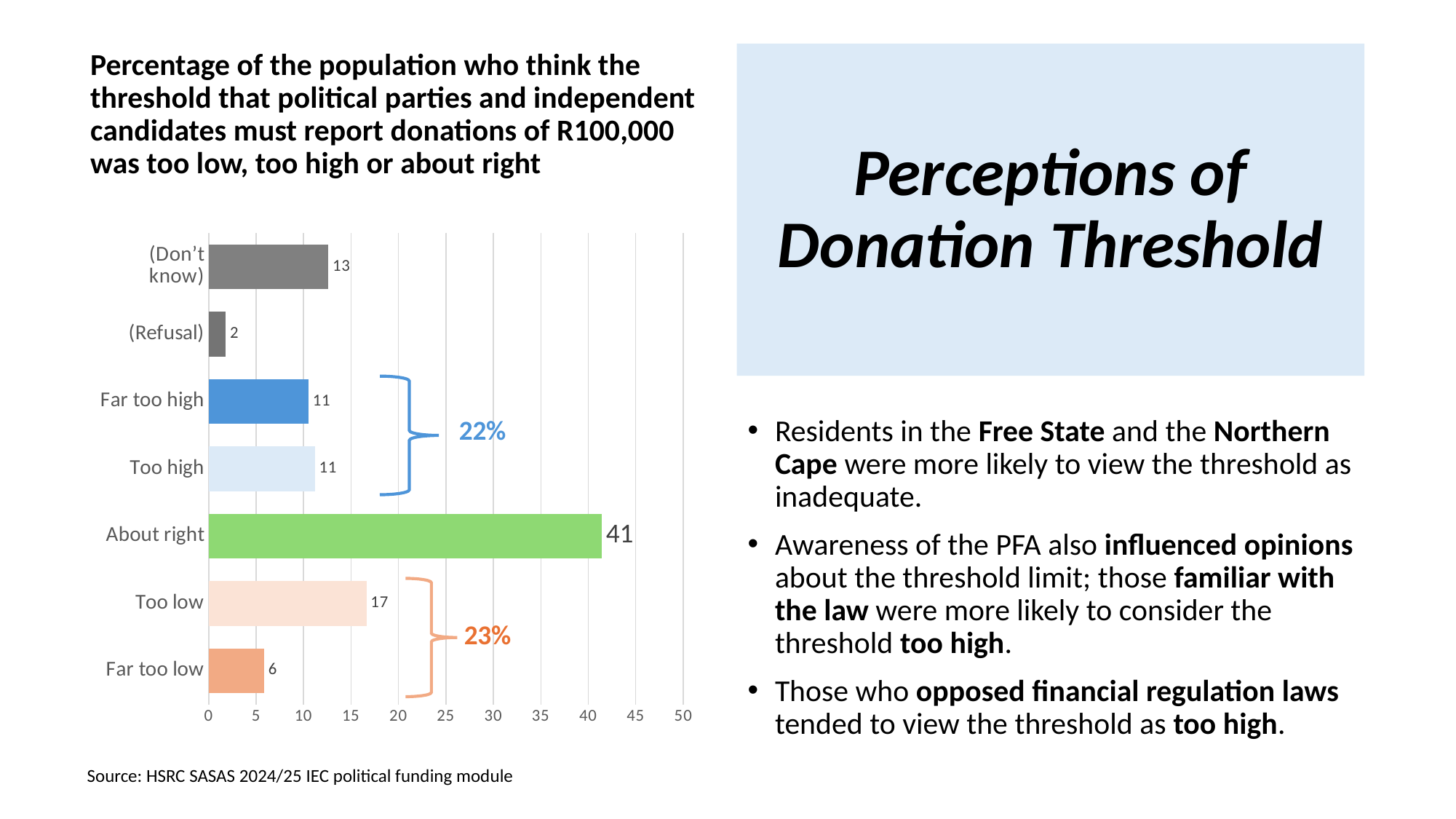
Which category has the highest value? About right What is the value for "Far too low"? 6 What is the difference between the values for "About right" and "Too low"? 24 How many categories are shown on the chart? 7 What is the value for "(Don't know)"? 13 What is the value for "Too low"? 17 Which is larger, the value for "Too low" or the value for "Far too high"? Too low Is the value for "About right" greater or less than 40? greater What kind of chart is shown on the slide? Bar chart What is the value for "About right"? 41 What combined percentage is shown by the bracket grouping "Too low" and "Far too low"? 23% Which category has the lowest value? (Refusal)